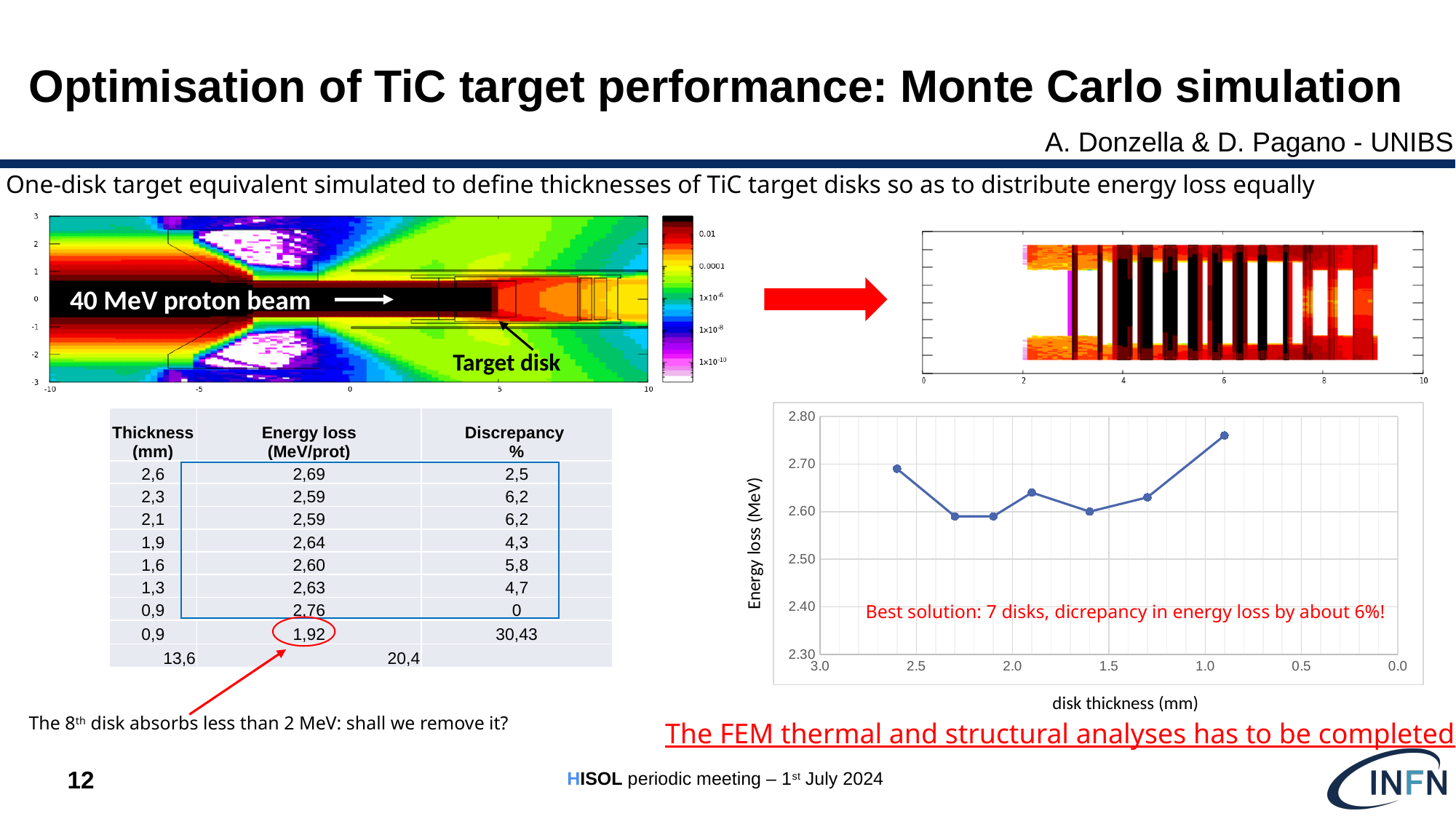
On the energy loss vs disk thickness chart, which disk thickness has the highest energy loss? 0.9 mm What kind of chart is shown on the right of the slide, plotting energy loss against disk thickness? line chart On the energy loss vs disk thickness chart, is the energy loss at 1.3 mm greater or less than 2.50 MeV? greater On the energy loss vs disk thickness chart, which has the larger energy loss: the 0.9 mm disk or the 2.6 mm disk? 0.9 mm How many data points are plotted on the energy loss vs disk thickness chart? 7 On the energy loss vs disk thickness chart, is the energy loss at 1.6 mm greater or less than 2.70 MeV? less On the energy loss vs disk thickness chart, is the energy loss at 2.6 mm greater or less than 2.60 MeV? greater What is the x-axis label of the line chart on the right of the slide? disk thickness (mm) What is the y-axis label of the energy loss vs disk thickness chart? Energy loss (MeV) On the energy loss vs disk thickness chart, does the line rise or fall between the 1.3 mm point and the 0.9 mm point? rises On the energy loss vs disk thickness chart, which has the larger energy loss: the 1.9 mm disk or the 2.3 mm disk? 1.9 mm